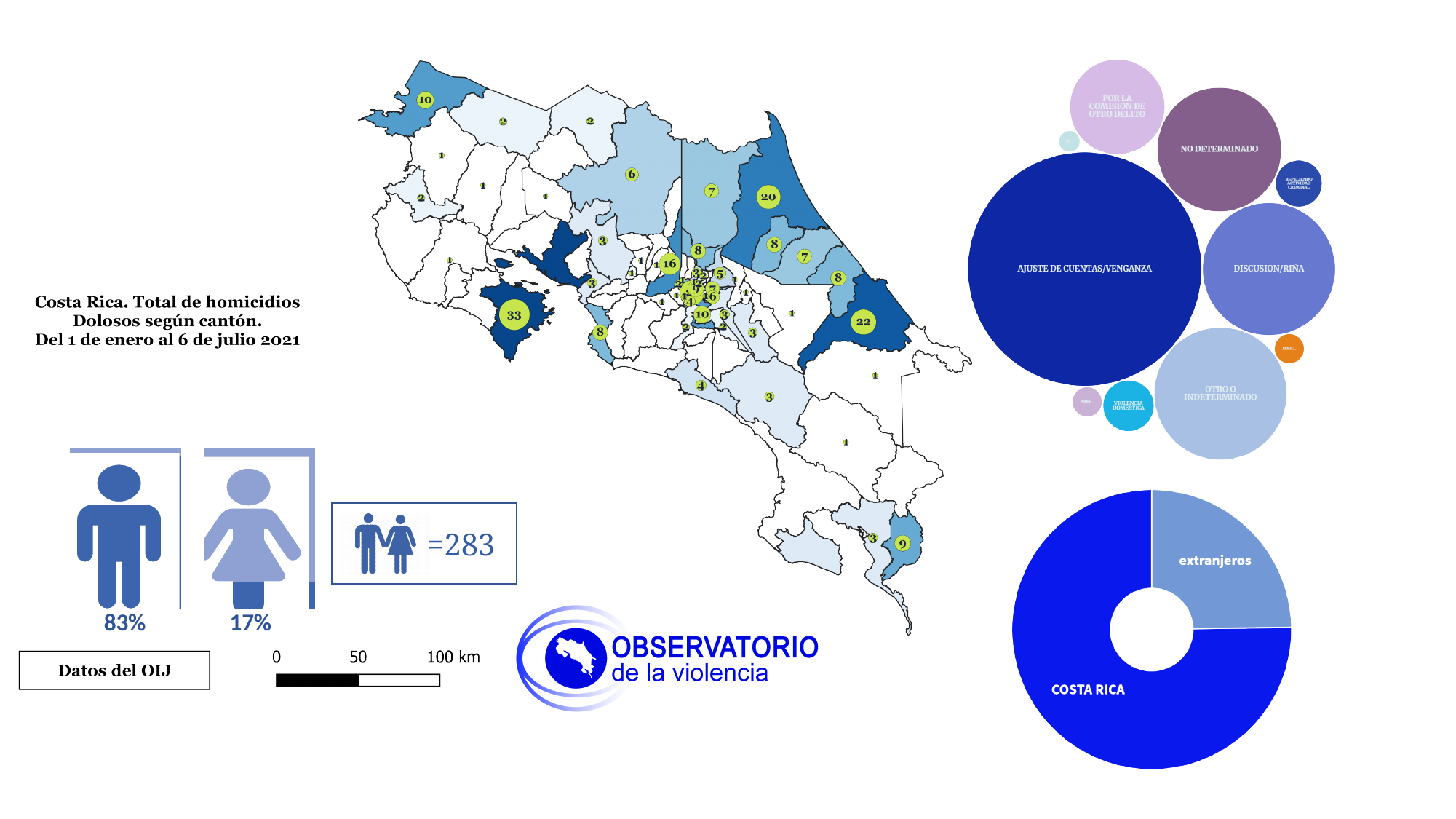
On the map, what is the highest number of homicides shown for a single canton? 33 In the donut chart at the bottom right, which of the two slices is larger, COSTA RICA or extranjeros? COSTA RICA In the bubble chart at the top right, which bubble is larger, OTRO O INDETERMINADO or VIOLENCIA DOMESTICA? OTRO O INDETERMINADO What is the total number of homicides shown in the box next to the gender figures? 283 In the bubble chart at the top right, which category has the largest bubble? AJUSTE DE CUENTAS/VENGANZA In the gender infographic at the bottom left, what percentage of homicide victims are women? 17% In the gender infographic at the bottom left, what percentage of homicide victims are men? 83% What kind of chart is the one at the bottom right showing COSTA RICA and extranjeros? Donut (pie) chart What period does the map title say the homicide data covers? Del 1 de enero al 6 de julio 2021 In the bubble chart at the top right, which bubble is larger, DISCUSION/RIÑA or NO DETERMINADO? DISCUSION/RIÑA How many slices does the donut chart at the bottom right have? 2 In the gender infographic, what is the difference in percentage points between men and women? 66 percentage points